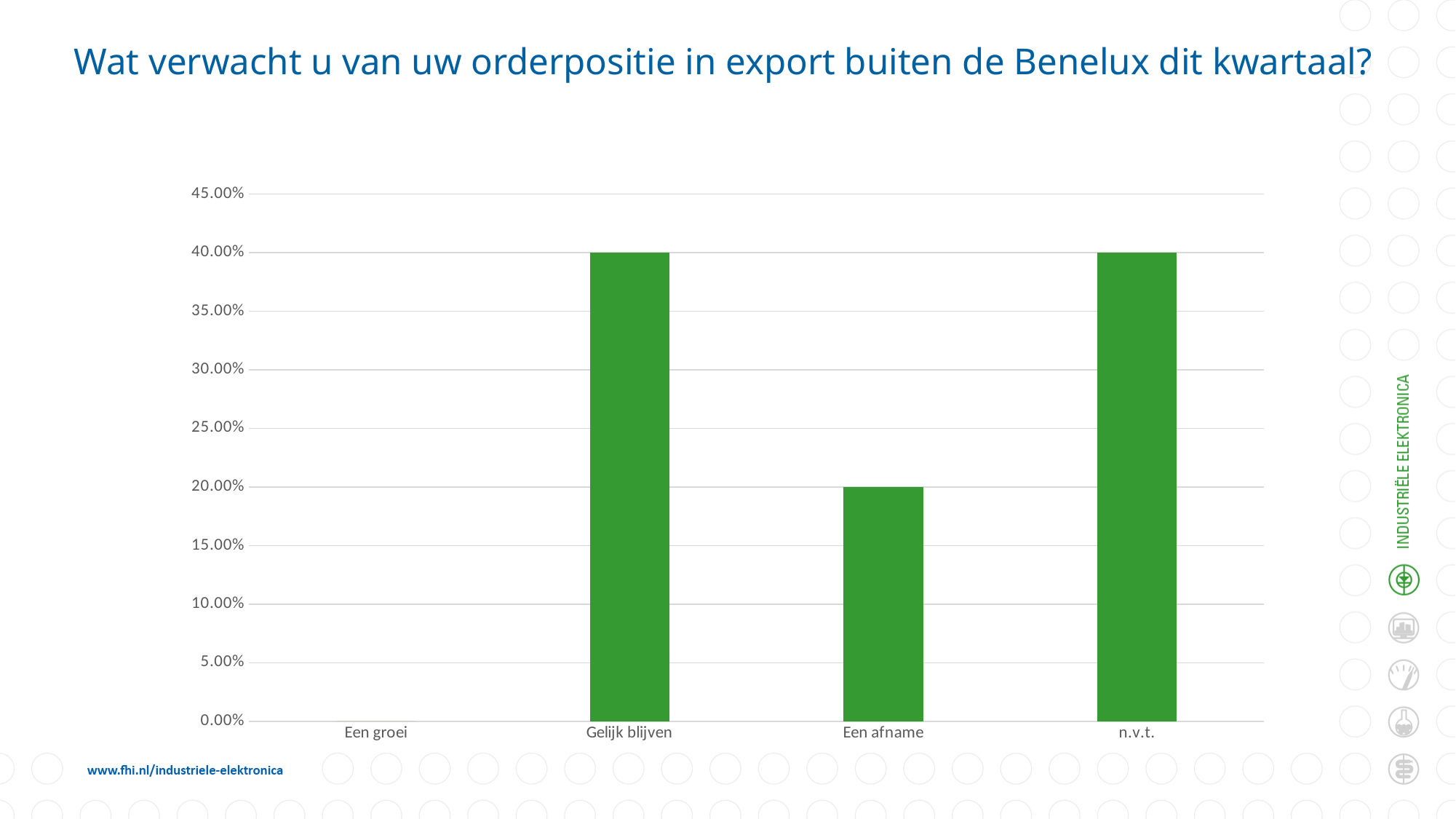
What is the difference between the values for 'Gelijk blijven' and 'Een afname'? 20.00% What kind of chart is shown on the slide? bar chart What is the value for 'Een groei'? 0.00% Is the value for 'Een afname' greater or less than 30.00%? less Is the value for 'n.v.t.' greater or less than 35.00%? greater How many categories are shown on the x axis of the chart? 4 What is the title of the slide containing the chart? Wat verwacht u van uw orderpositie in export buiten de Benelux dit kwartaal? What is the value for 'n.v.t.'? 40.00% Which is larger, the value for 'Gelijk blijven' or the value for 'Een afname'? Gelijk blijven Which category has the lowest value? Een groei What is the value for 'Een afname'? 20.00% What is the value for 'Gelijk blijven'? 40.00%